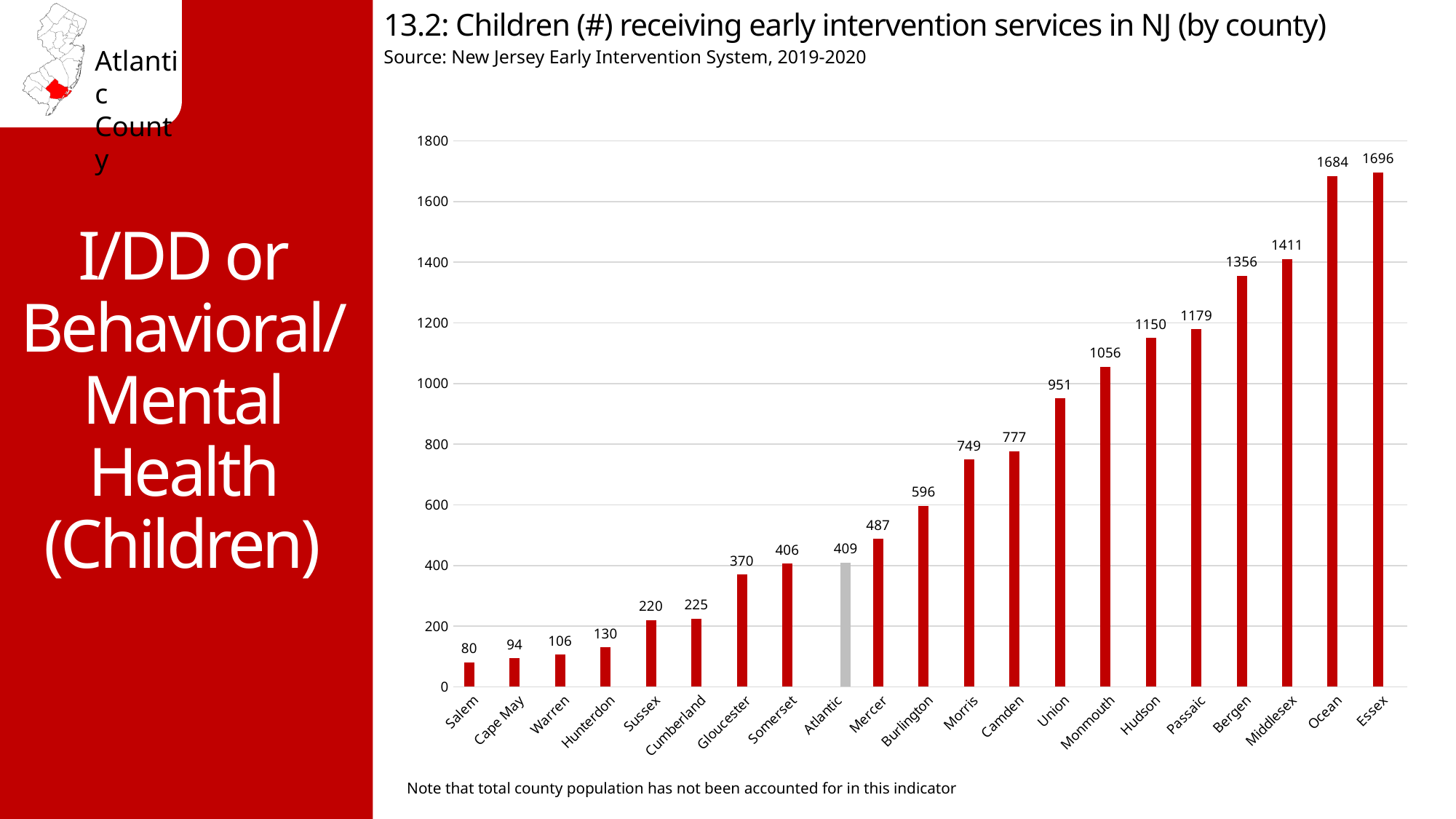
What kind of chart is shown on the slide? Bar chart What is the value shown for Bergen County? 1356 Do the values rise or fall moving from left to right along the x axis? Rise Which county's bar is coloured grey instead of red? Atlantic Which county has the highest number of children receiving early intervention services? Essex What is the difference between the values for Essex and Ocean? 12 How many counties are shown on the chart? 21 Is the value for Union greater or less than 1000? less How many children received early intervention services in Atlantic County? 409 Which county has a larger value, Camden or Morris? Camden What is the difference between the values for Atlantic and Somerset? 3 Which county has the lowest number of children receiving early intervention services? Salem